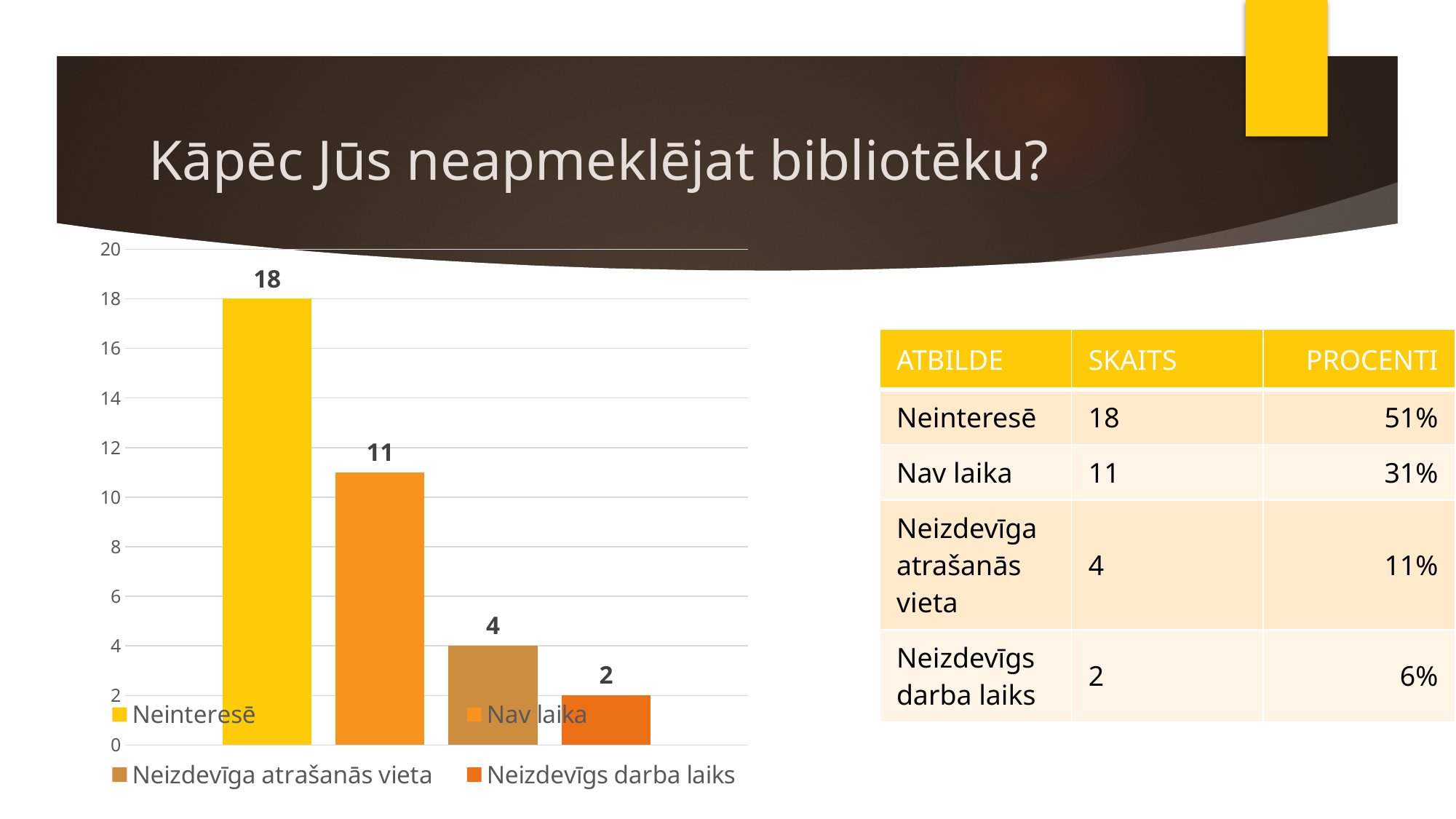
How many bars are shown in the chart? 4 Is the value for Neinteresē greater or less than 16? greater What kind of chart is shown on the slide? bar chart What is the value for Neizdevīga atrašanās vieta? 4 What is the value for Neizdevīgs darba laiks? 2 What is the value for Nav laika? 11 Which category has the highest value? Neinteresē How many entries does the chart legend list? 4 Which is larger, the value for Nav laika or the value for Neizdevīga atrašanās vieta? Nav laika What is the value for Neinteresē? 18 What is the difference between the values for Neinteresē and Nav laika? 7 Which category has the lowest value? Neizdevīgs darba laiks